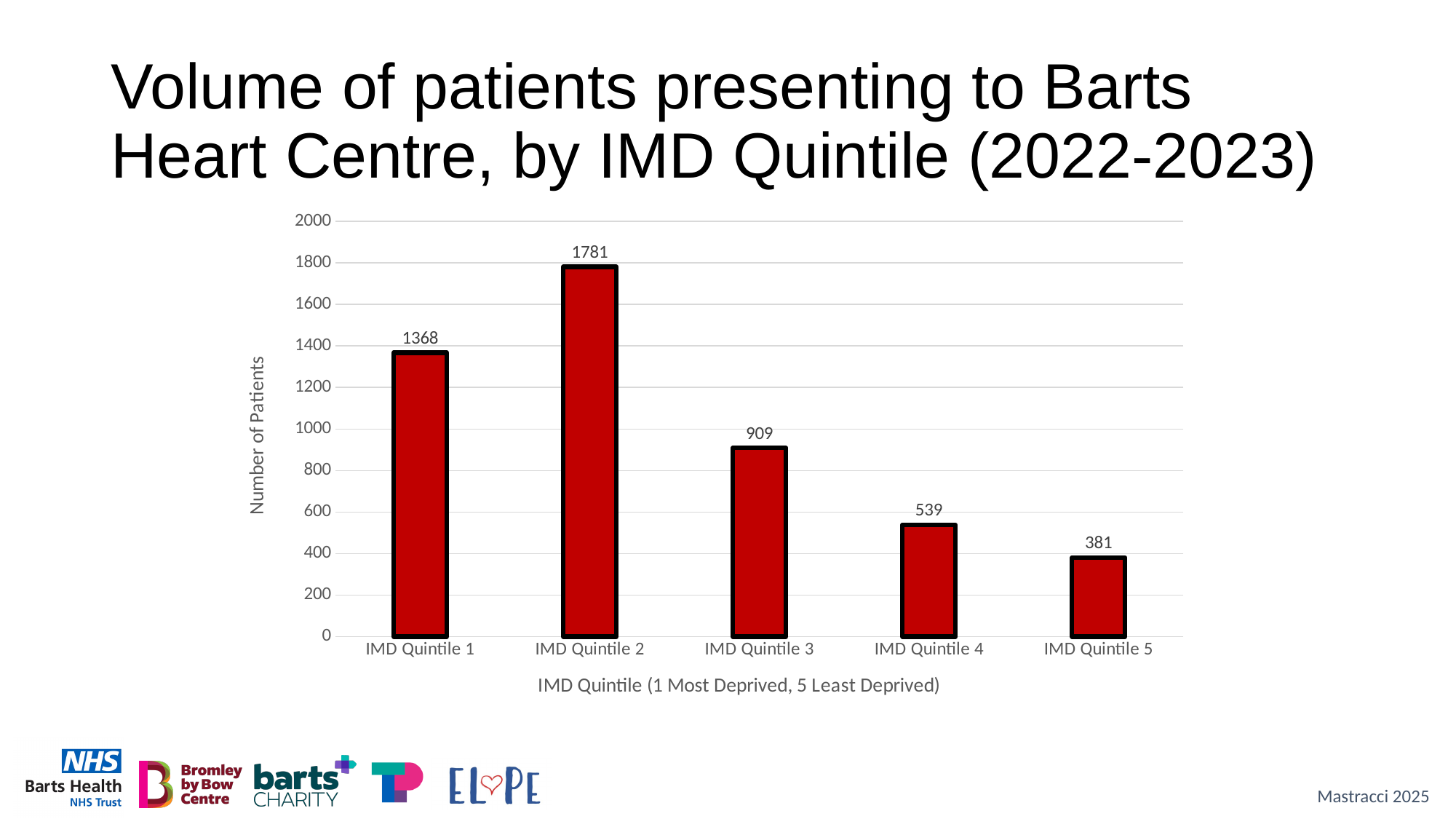
What kind of chart is shown on the slide? Bar chart What is the number of patients for IMD Quintile 3? 909 What is the label of the vertical axis? Number of Patients Which IMD quintile has the highest number of patients? IMD Quintile 2 How many IMD quintile categories are shown on the chart? 5 Is the value for IMD Quintile 4 greater or less than 600? less How many patients presented from IMD Quintile 1? 1368 What is the number of patients for IMD Quintile 5? 381 Which has more patients, IMD Quintile 3 or IMD Quintile 4? IMD Quintile 3 What is the difference in number of patients between IMD Quintile 4 and IMD Quintile 5? 158 What is the difference in number of patients between IMD Quintile 2 and IMD Quintile 1? 413 Which IMD quintile has the lowest number of patients? IMD Quintile 5